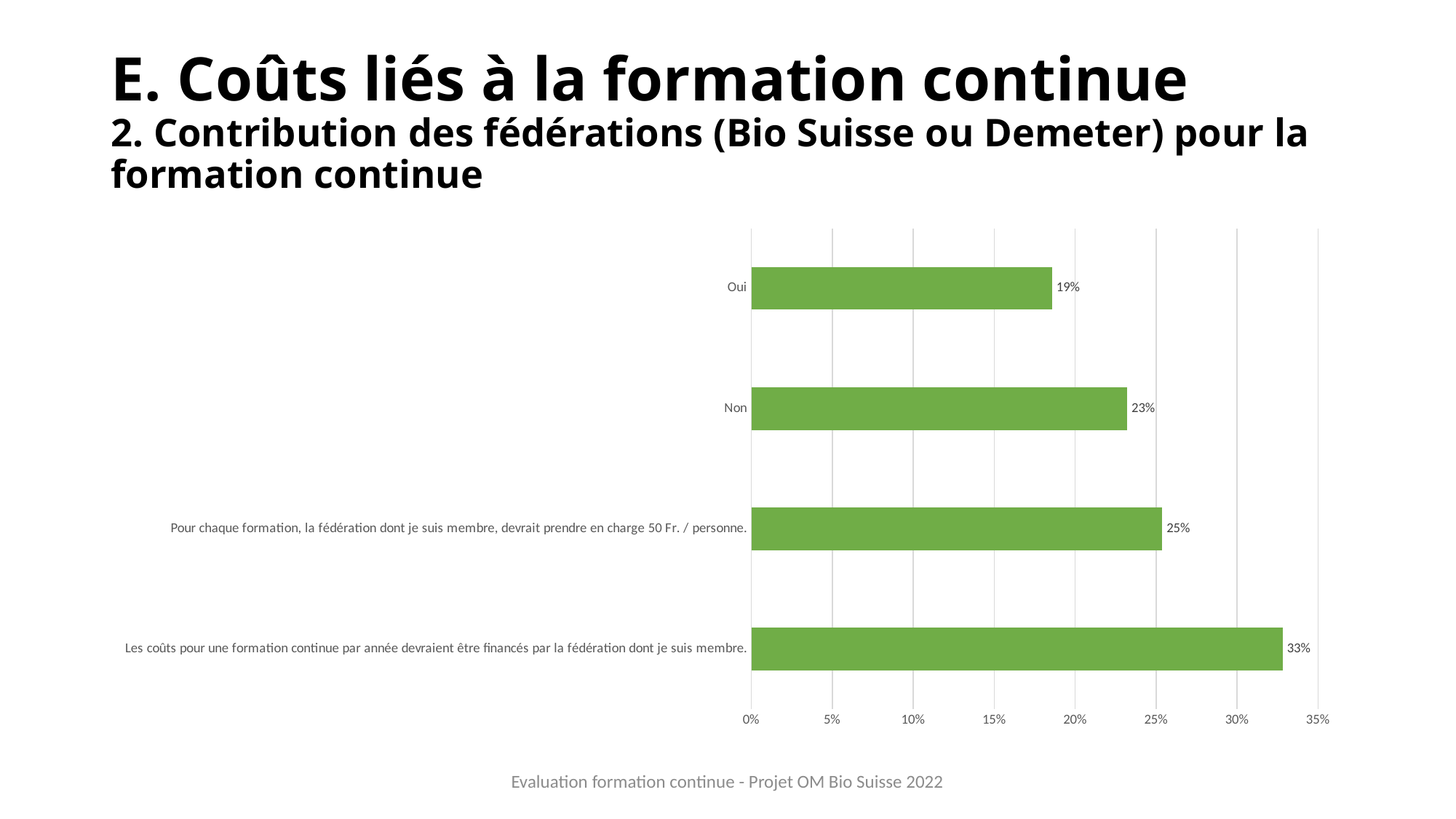
What is the value for "Les coûts pour une formation continue par année devraient être financés par la fédération dont je suis membre."? 33% How many categories are shown in the chart? 4 What is the value for "Pour chaque formation, la fédération dont je suis membre, devrait prendre en charge 50 Fr. / personne."? 25% What is the value for "Non"? 23% What kind of chart is shown on the slide? bar chart Which category has the lowest value? Oui Which is larger, the value for "Non" or the value for "Pour chaque formation, la fédération dont je suis membre, devrait prendre en charge 50 Fr. / personne."? Pour chaque formation, la fédération dont je suis membre, devrait prendre en charge 50 Fr. / personne. What is the value for "Oui"? 19% What is the difference between the values for "Non" and "Oui"? 4% Which category has the highest value? Les coûts pour une formation continue par année devraient être financés par la fédération dont je suis membre. Is the value for "Oui" greater or less than 20%? less What is the difference between the highest and lowest values in the chart? 14%